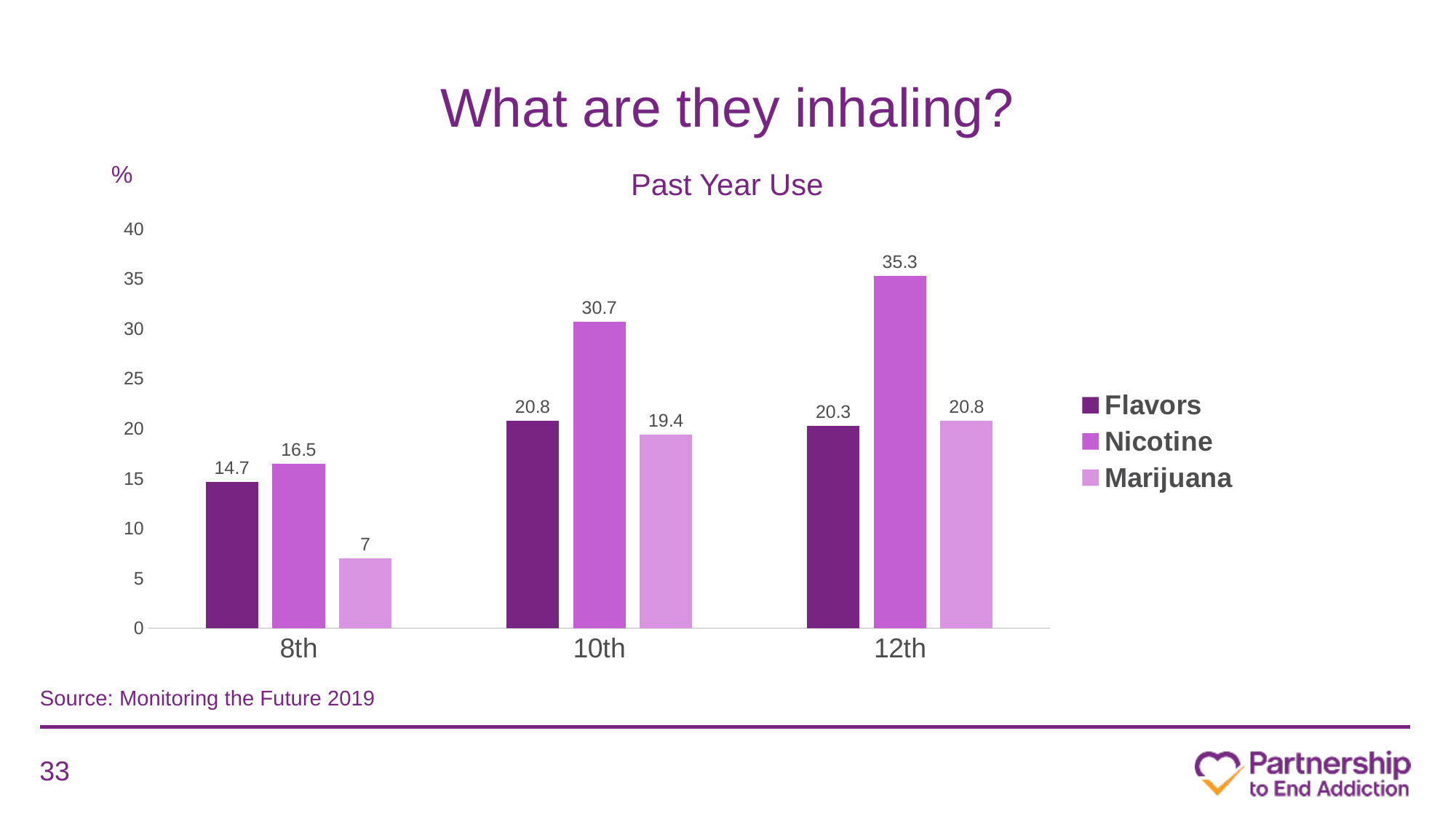
How many series does the legend list? 3 What is the title of the chart? Past Year Use Which grade has the lowest Marijuana value? 8th What kind of chart is shown? Bar chart What is the difference between the Nicotine and Flavors values for 12th grade? 15 What is the Flavors value for 12th grade? 20.3 How many grade categories are shown on the x axis? 3 Do the Nicotine values rise or fall from 8th to 12th grade? Rise Which grade has the highest Nicotine value? 12th Which is larger for 10th grade, Flavors or Marijuana? Flavors What is the Marijuana value for 8th grade? 7 What is the Nicotine value for 10th grade? 30.7